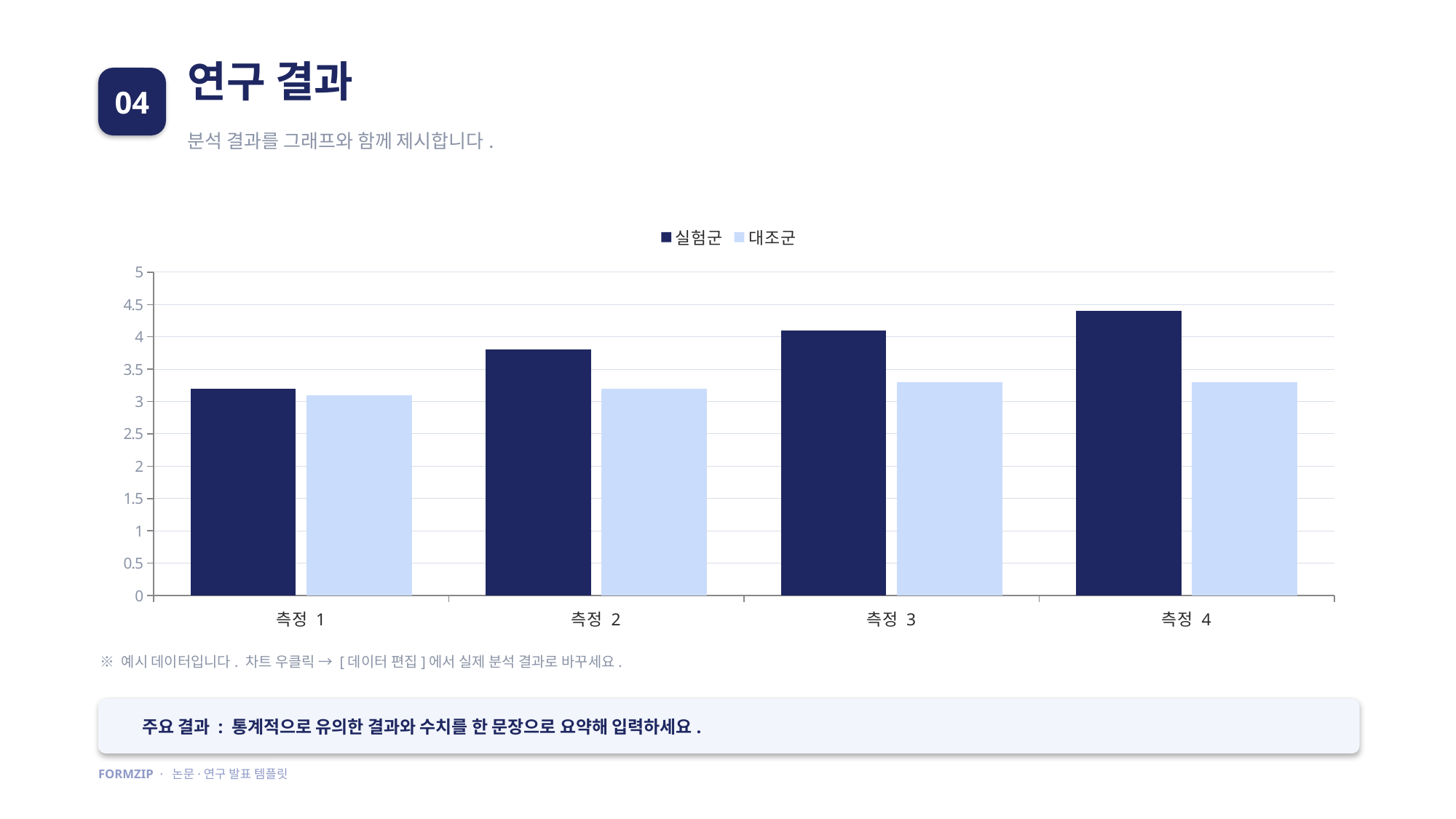
What kind of chart is shown on the slide? bar chart What are the two series names listed in the chart's legend? 실험군, 대조군 Is the value for 실험군 at 측정 4 greater or less than 4? greater For 측정 2, which series has the larger value, 실험군 or 대조군? 실험군 Is the value for 실험군 at 측정 2 greater or less than 4? less Which series is larger at 측정 4, 실험군 or 대조군? 실험군 Is the value for 대조군 at 측정 1 greater or less than 3.5? less How many categories are shown on the x axis of the chart? 4 Do the values for 실험군 rise or fall from 측정 1 to 측정 4? rise Which category has the lowest value for 실험군? 측정 1 Which category has the highest value for 실험군? 측정 4 How many series does the chart's legend list? 2